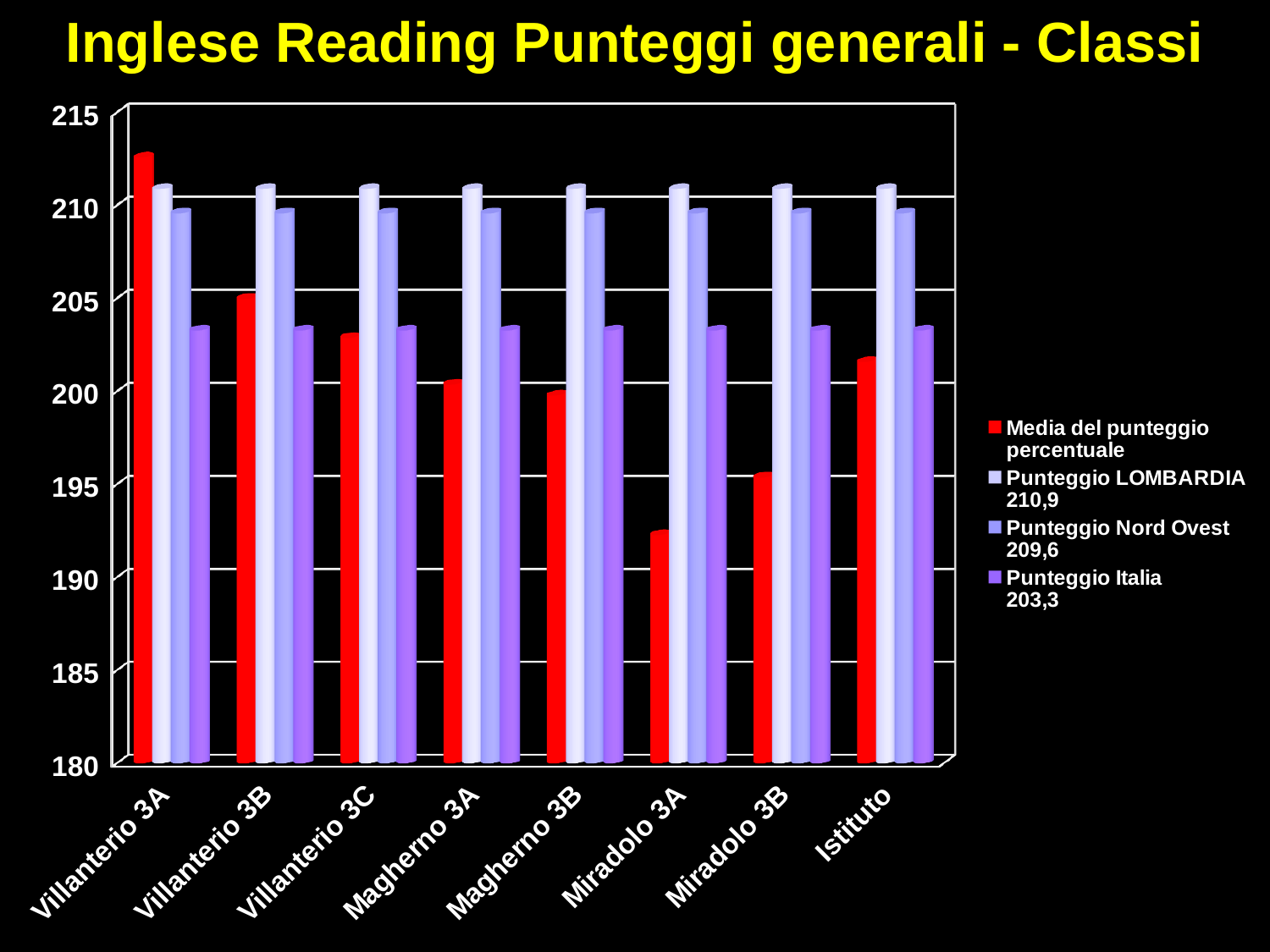
What kind of chart is shown on the slide? bar chart Which is larger, the 'Media del punteggio percentuale' for Villanterio 3B or for Magherno 3B? Villanterio 3B What is the difference between the 'Punteggio LOMBARDIA' and the 'Punteggio Italia' values? 7,6 Which class has the lowest 'Media del punteggio percentuale'? Miradolo 3A What is the 'Punteggio Italia' value shown in the legend? 203,3 What is the 'Punteggio Nord Ovest' value shown in the legend? 209,6 What is the 'Punteggio LOMBARDIA' value shown in the legend? 210,9 Is the 'Media del punteggio percentuale' for Miradolo 3A greater or less than 195? less How many categories are shown on the x axis? 8 Which class has the highest 'Media del punteggio percentuale'? Villanterio 3A What is the title of the chart? Inglese Reading Punteggi generali - Classi How many series does the legend list? 4